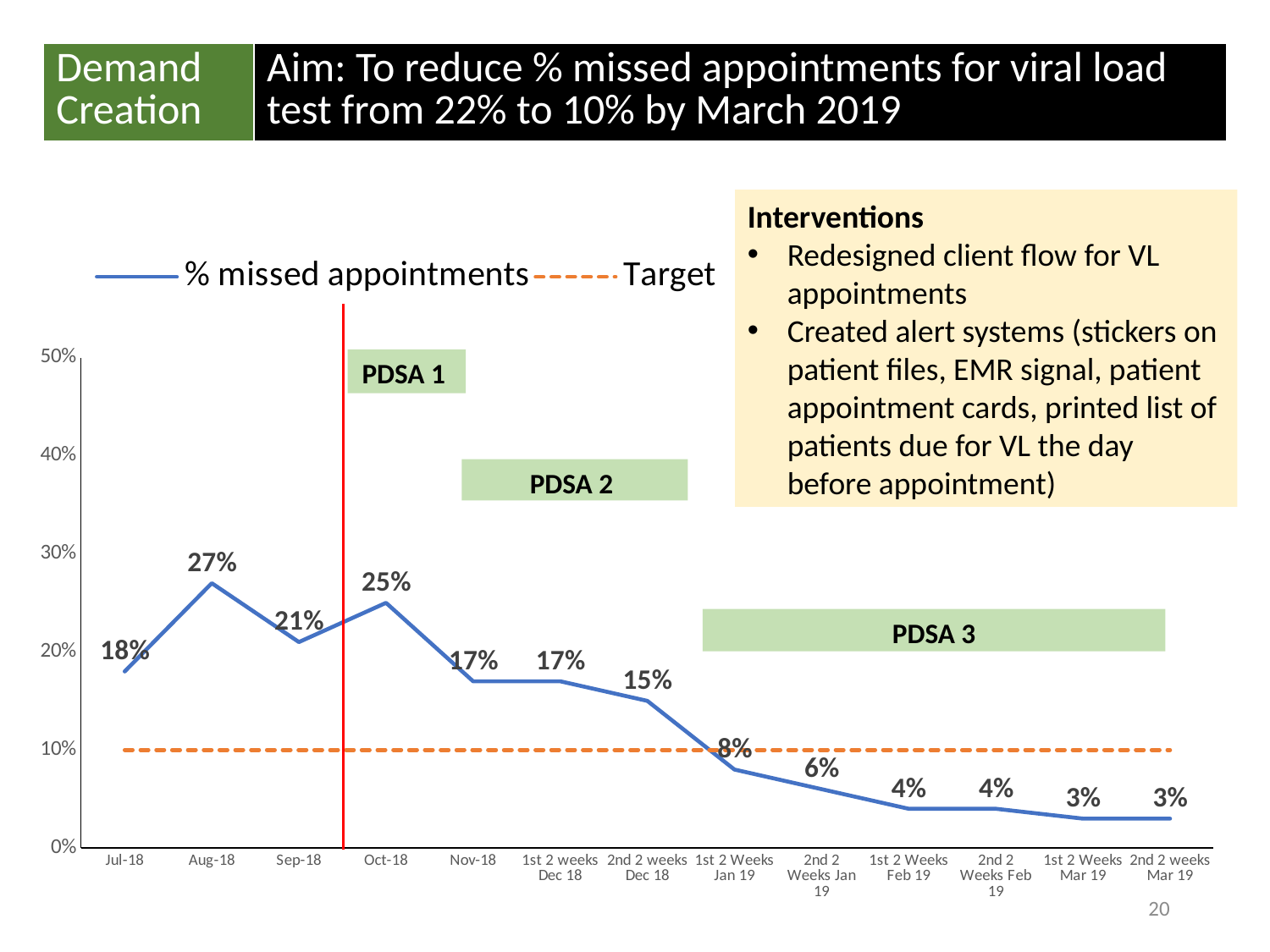
Which category has the highest % missed appointments? Aug-18 What is the difference in % missed appointments between Jul-18 and the 2nd 2 weeks of Mar 19? 15% Does the % missed appointments series generally rise or fall from Oct-18 to the 2nd 2 weeks of Mar 19? Fall What is the % missed appointments value for the 2nd 2 weeks of Jan 19? 6% Which is larger, the % missed appointments for Oct-18 or for Sep-18? Oct-18 What is the difference in % missed appointments between Aug-18 and Sep-18? 6% How many series does the legend list? 2 What is the % missed appointments value for Nov-18? 17% Is the % missed appointments value for the 2nd 2 weeks of Dec 18 greater or less than 10%? greater What is the % missed appointments value for Aug-18? 27% What kind of chart is shown on the slide? Line chart How many time periods are shown on the x axis? 13